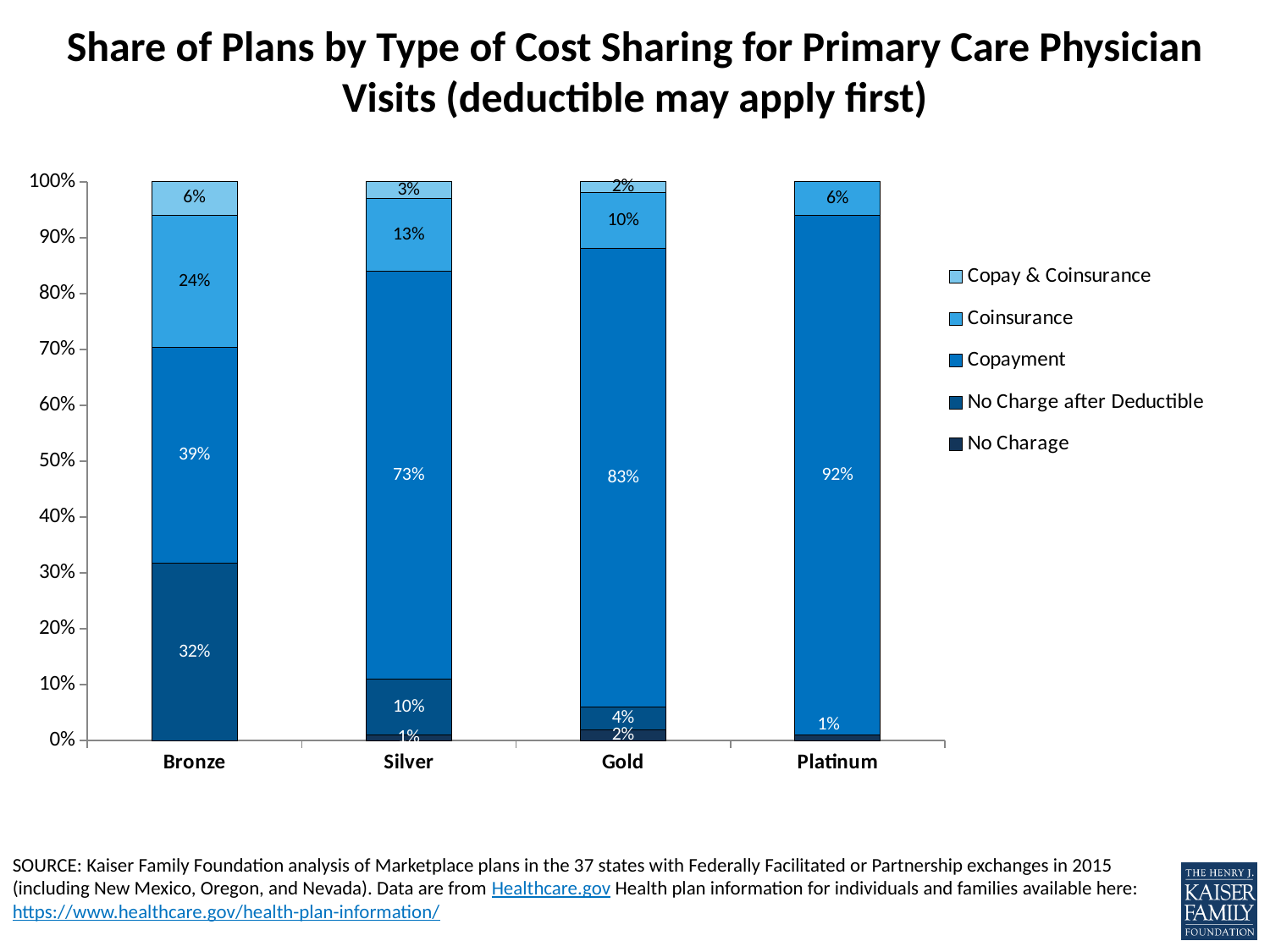
What share of Bronze plans use a Copayment? 39% Which plan type has the highest share of plans using a Copayment? Platinum How many plan types are shown on the x axis? 4 Which plan type has the lowest share of plans using a Copayment? Bronze How many cost-sharing types does the legend list? 5 What share of Platinum plans use a Copayment for primary care physician visits? 92% What share of Silver plans use Coinsurance? 13% How many percentage points higher is the Copayment share for Gold than for Silver? 10 percentage points Does the Copayment share rise or fall moving from Bronze to Platinum? Rises What share of Bronze plans use Copay & Coinsurance? 6% Which has a larger Coinsurance share, Bronze or Gold? Bronze What share of Silver plans have No Charge after Deductible? 10%